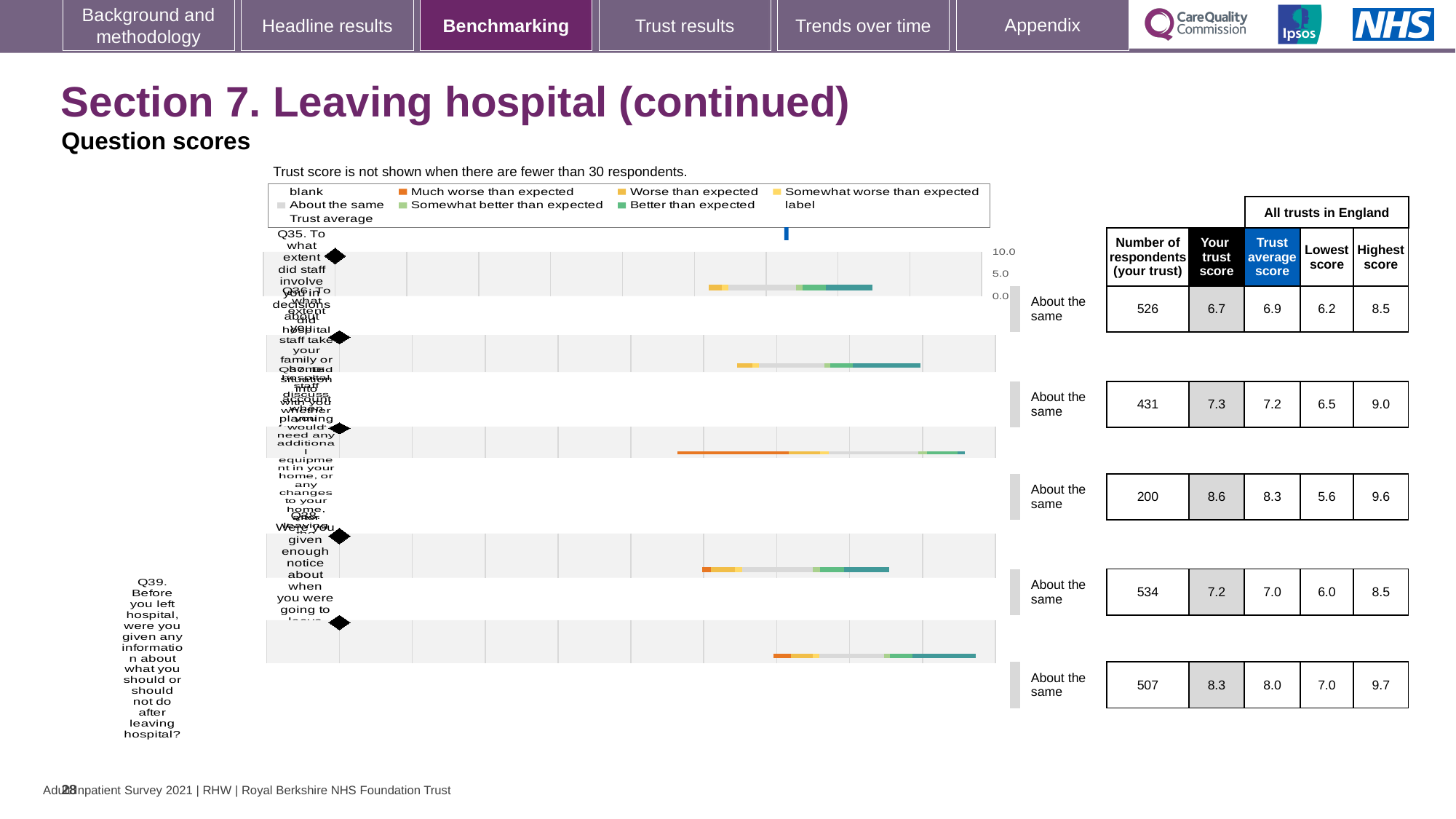
What is the trust score for Q39 (information about what you should or should not do after leaving hospital)? 8.3 Which question has the highest 'Your trust score'? Q37 What kind of chart is used to show the question scores? Bar chart What benchmark category is shown for every question on this slide? About the same How many questions are shown in the chart? 5 For Q39, which is larger: the trust score or the trust average score? Trust score Which question has the lowest 'Your trust score'? Q35 Is the trust score for Q35 greater or less than 5.0? greater How many respondents answered Q35 (to what extent did staff involve you in decisions about leaving hospital)? 526 What is the highest score across all trusts in England for Q37 (additional equipment or changes to your home)? 9.6 What is the difference between the trust score and the trust average score for Q37? 0.3 What is the trust average score for Q36 (staff taking your family or home situation into account)? 7.2